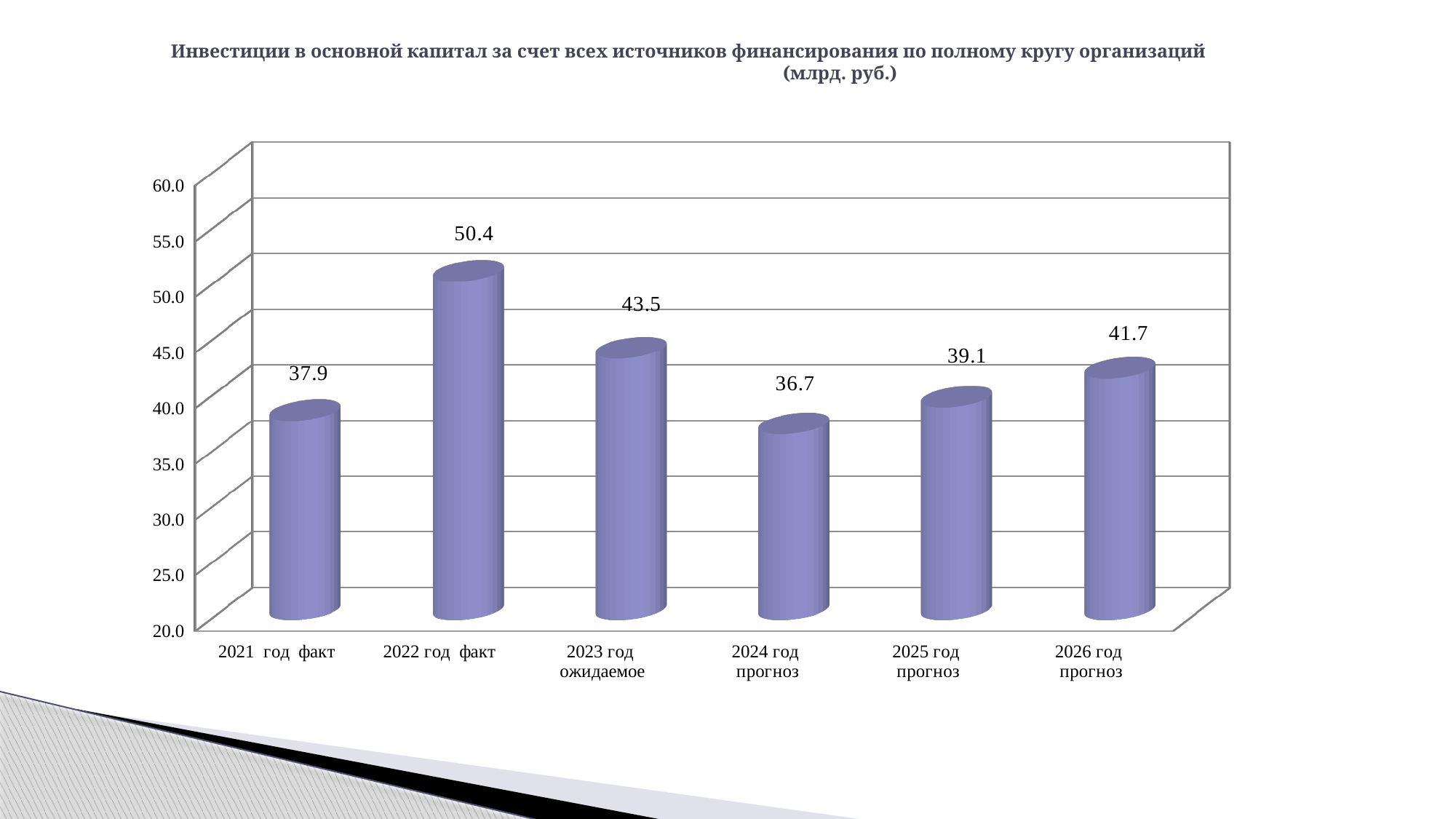
What is the value for 2022 год факт? 50.4 How many categories are shown on the x axis? 6 Which category has the highest value? 2022 год факт What unit is given in the chart title? млрд. руб. What is the value for 2026 год прогноз? 41.7 What is the difference between the values for 2022 год факт and 2023 год ожидаемое? 6.9 What is the value for 2024 год прогноз? 36.7 Which category has the lowest value? 2024 год прогноз What kind of chart is this? bar chart Do the values rise or fall from 2024 год прогноз to 2026 год прогноз? rise What is the difference between the values for 2026 год прогноз and 2025 год прогноз? 2.6 Which is larger, the value for 2021 год факт or the value for 2025 год прогноз? 2025 год прогноз